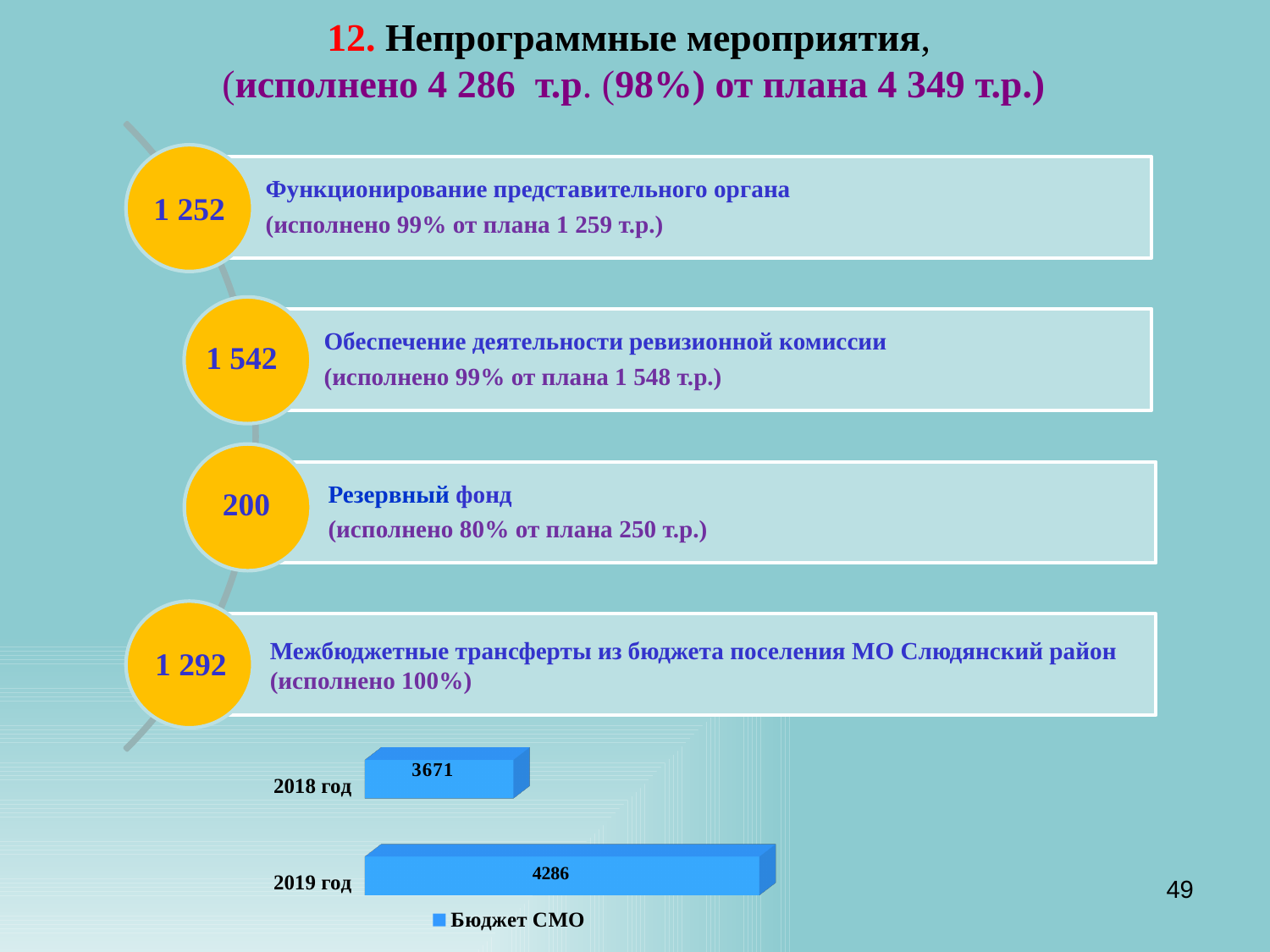
Is the value for 2018 год larger or smaller than the value for 2019 год? smaller How many bars are shown in the bar chart? 2 What is the difference between the 2019 год and 2018 год values in the bar chart? 615 What colour are the bars in the bar chart? blue What is the value for 2019 год in the bar chart? 4286 Which year has the lower value in the bar chart? 2018 год What kind of chart is shown at the bottom of the slide? bar chart Does the value rise or fall from 2018 год to 2019 год in the bar chart? rise How many series does the legend of the bar chart list? 1 What is the value for 2018 год in the bar chart? 3671 Which year has the higher value in the bar chart? 2019 год What is the legend entry of the bar chart? Бюджет СМО